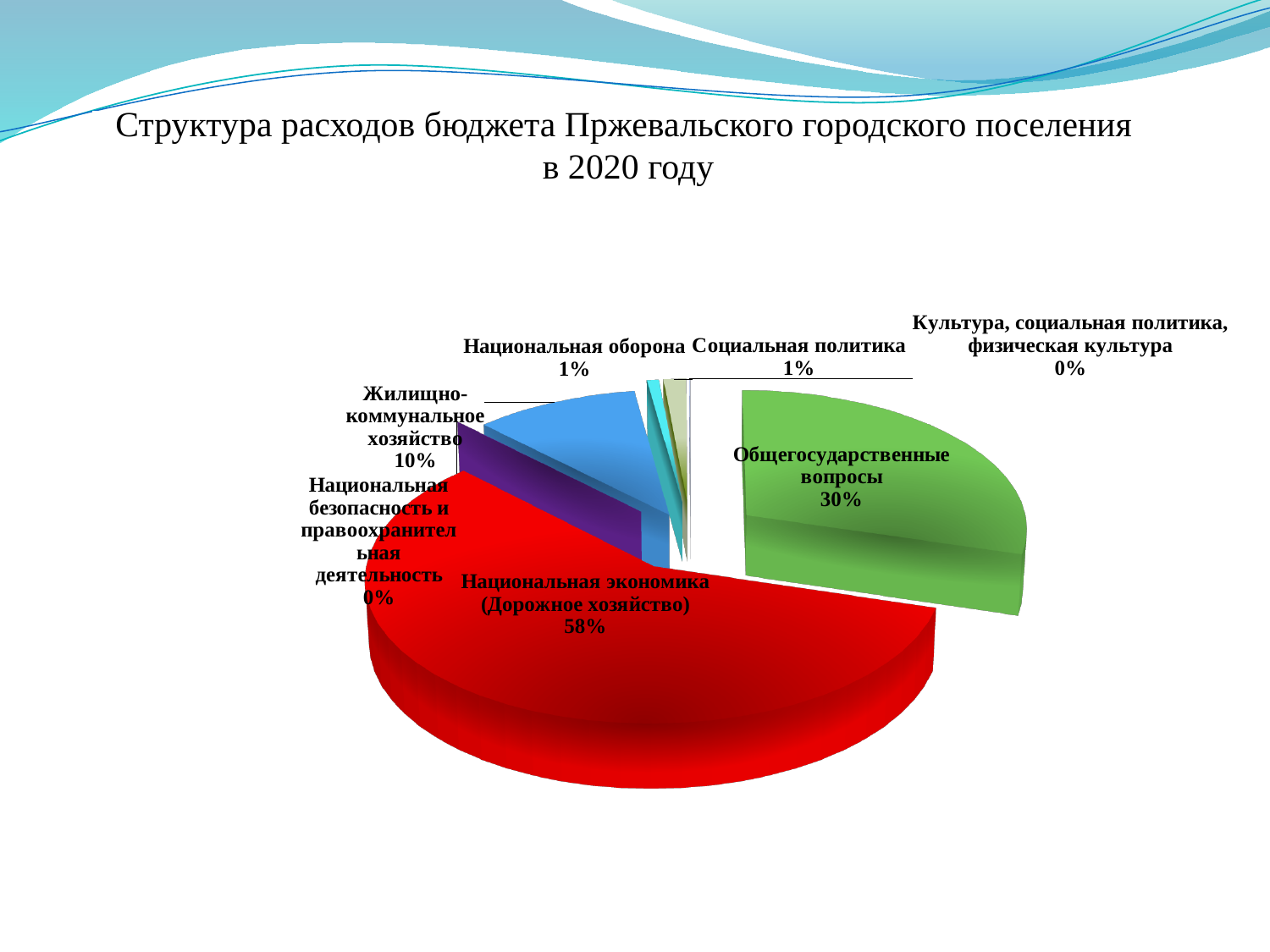
What kind of chart is shown on the slide? Pie chart What is the title of the slide? Структура расходов бюджета Пржевальского городского поселения в 2020 году What share of the budget expenditure goes to Жилищно-коммунальное хозяйство? 10% What share of the budget expenditure goes to Общегосударственные вопросы? 30% Which is larger: the share for Общегосударственные вопросы or the share for Жилищно-коммунальное хозяйство? Общегосударственные вопросы How many categories are labelled on the pie chart? 7 Which category has the largest share of the budget expenditure? Национальная экономика (Дорожное хозяйство) What share of the budget expenditure goes to Национальная экономика (Дорожное хозяйство)? 58% What is the difference in percentage points between the share for Национальная экономика (Дорожное хозяйство) and the share for Общегосударственные вопросы? 28 percentage points